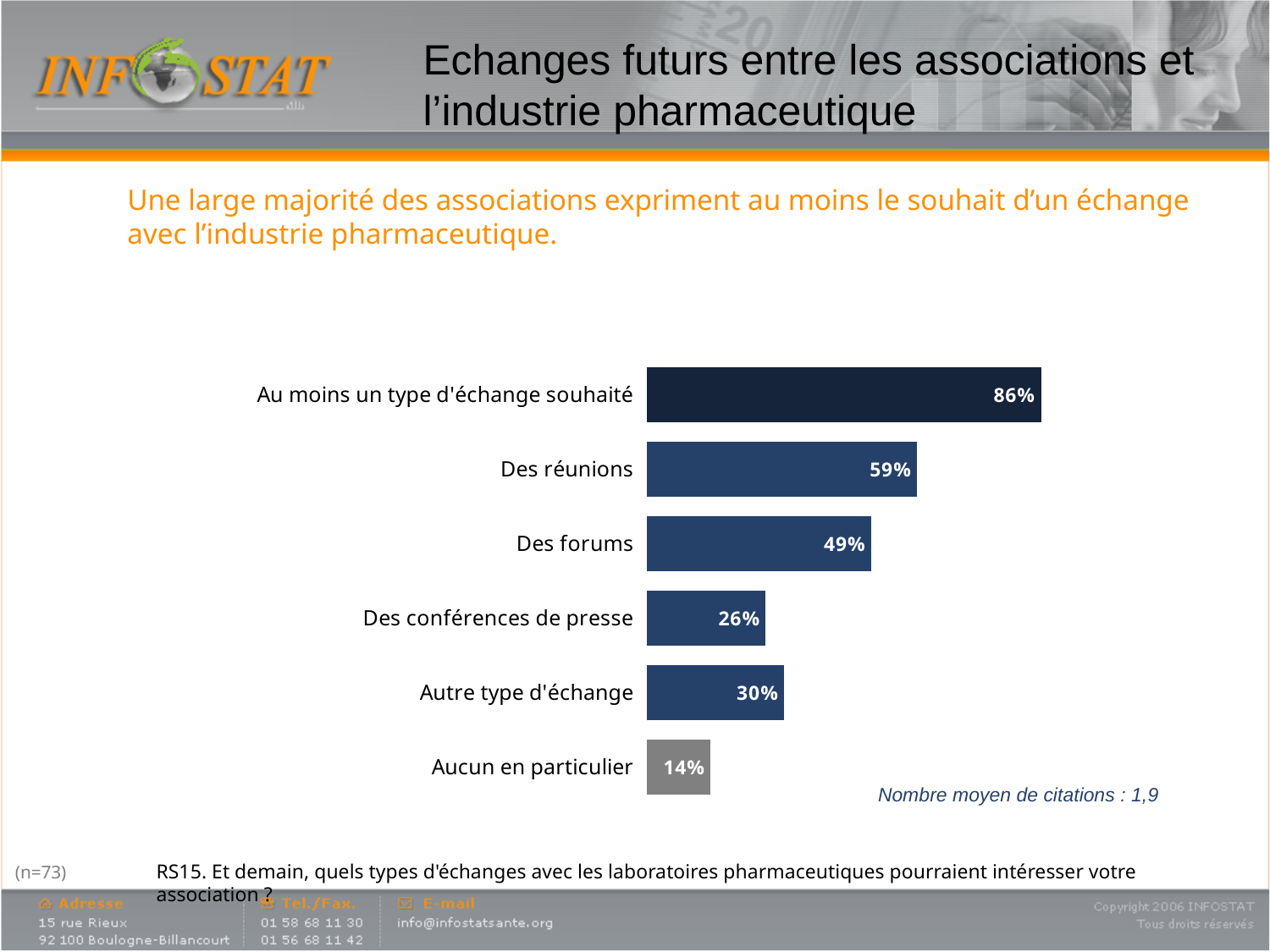
What is the value for "Des forums"? 49% What is the average number of citations noted below the chart? 1,9 What is the difference between the values for "Des réunions" and "Des forums"? 10% How many categories are shown in the chart? 6 What is the value for "Des conférences de presse"? 26% Which category has the lowest value? Aucun en particulier What is the value for "Des réunions"? 59% What kind of chart is shown on the slide? Bar chart What is the difference between the values for "Autre type d'échange" and "Des conférences de presse"? 4% Which is larger, the value for "Autre type d'échange" or the value for "Des conférences de presse"? Autre type d'échange Which category has the highest value? Au moins un type d'échange souhaité What is the value for "Aucun en particulier"? 14%